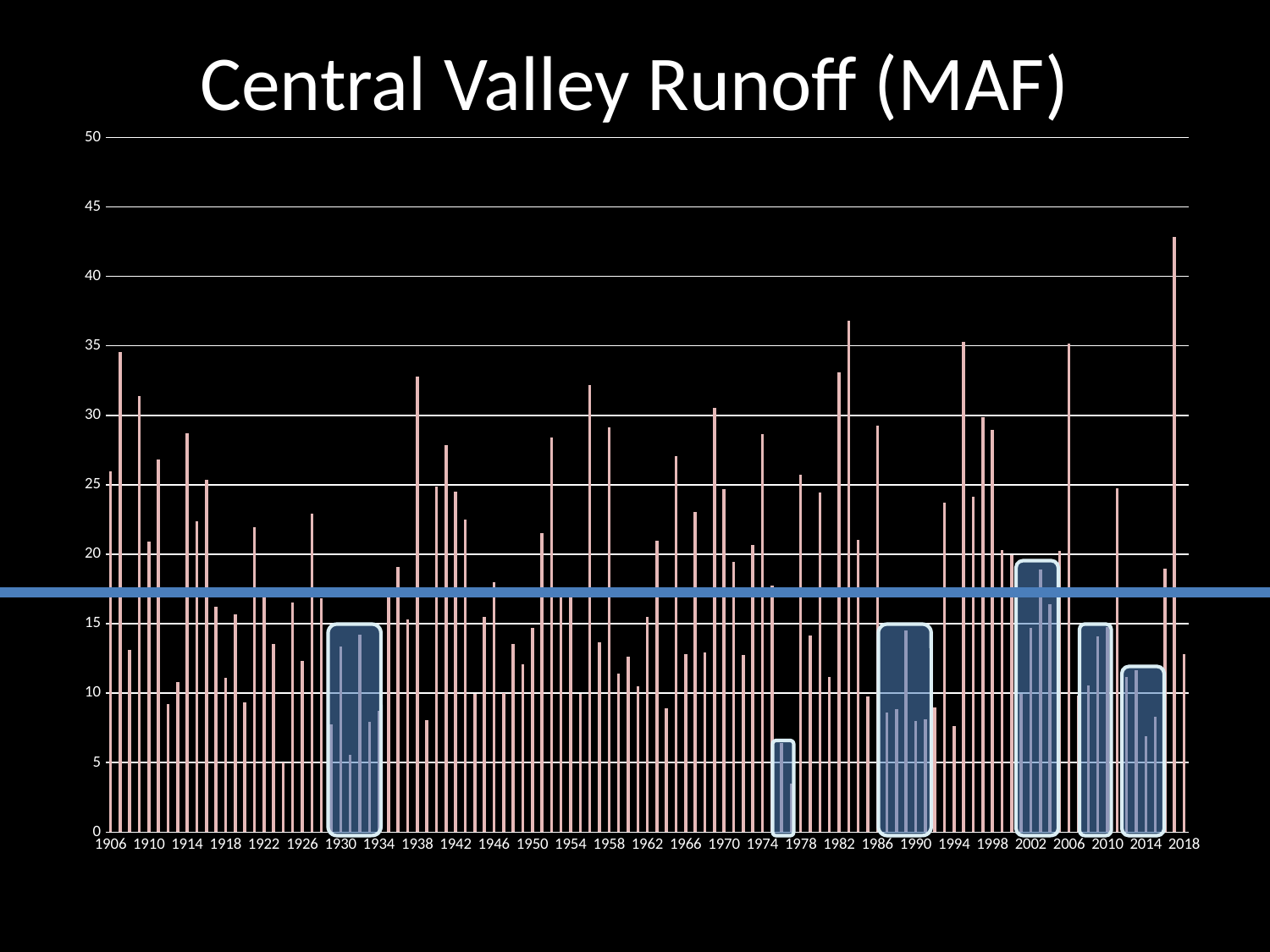
Which year has the larger runoff value, 2017 or 1983? 2017 Is the runoff value for 1977 greater or less than 10? less What kind of chart is shown on the slide? bar chart How many highlighted boxes are drawn over groups of bars on the chart? 6 Is the runoff value for 1983 greater or less than 35? greater What is the title of the chart? Central Valley Runoff (MAF) Is the runoff value for 2006 greater or less than 30? greater Which year has the larger runoff value, 2006 or 2011? 2006 Which year has the highest runoff value in the chart? 2017